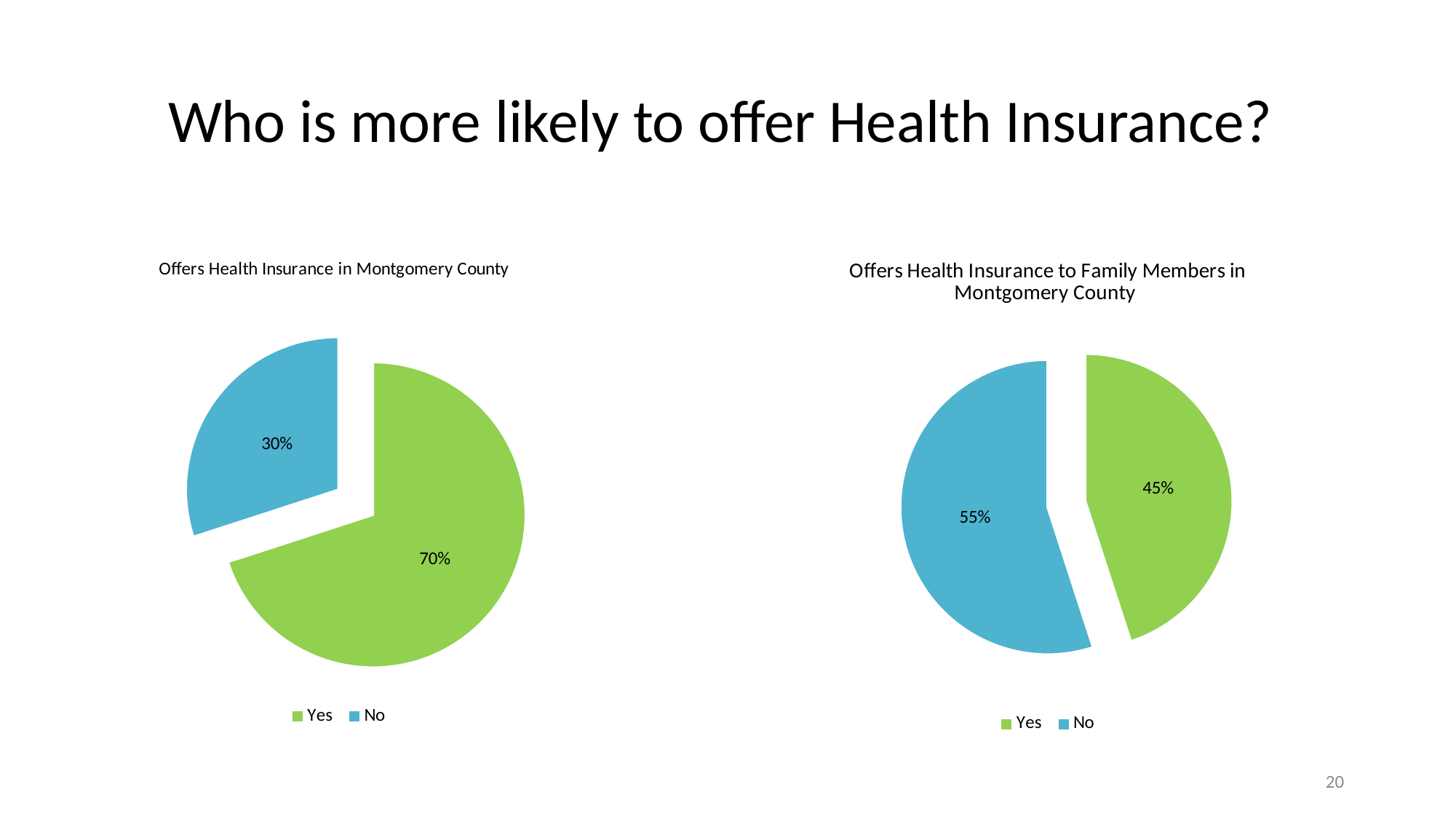
In the chart titled "Offers Health Insurance in Montgomery County", what is the value for "No"? 30% In the chart titled "Offers Health Insurance in Montgomery County", what share of the pie is "Yes"? 70% In the right chart, which slice is the smallest? Yes In the right chart, what is the difference between the "No" and "Yes" slices? 10% What kind of chart is the left chart? Pie chart In the right chart, which is larger, "Yes" or "No"? No In the left chart, what colour is the "No" slice? Blue In the chart titled "Offers Health Insurance to Family Members in Montgomery County", what is the value for "No"? 55% How many slices does the right chart have? 2 In the chart titled "Offers Health Insurance to Family Members in Montgomery County", what share of the pie is "Yes"? 45% In the left chart, what is the difference between the "Yes" and "No" slices? 40% In the left chart, which slice is the largest? Yes